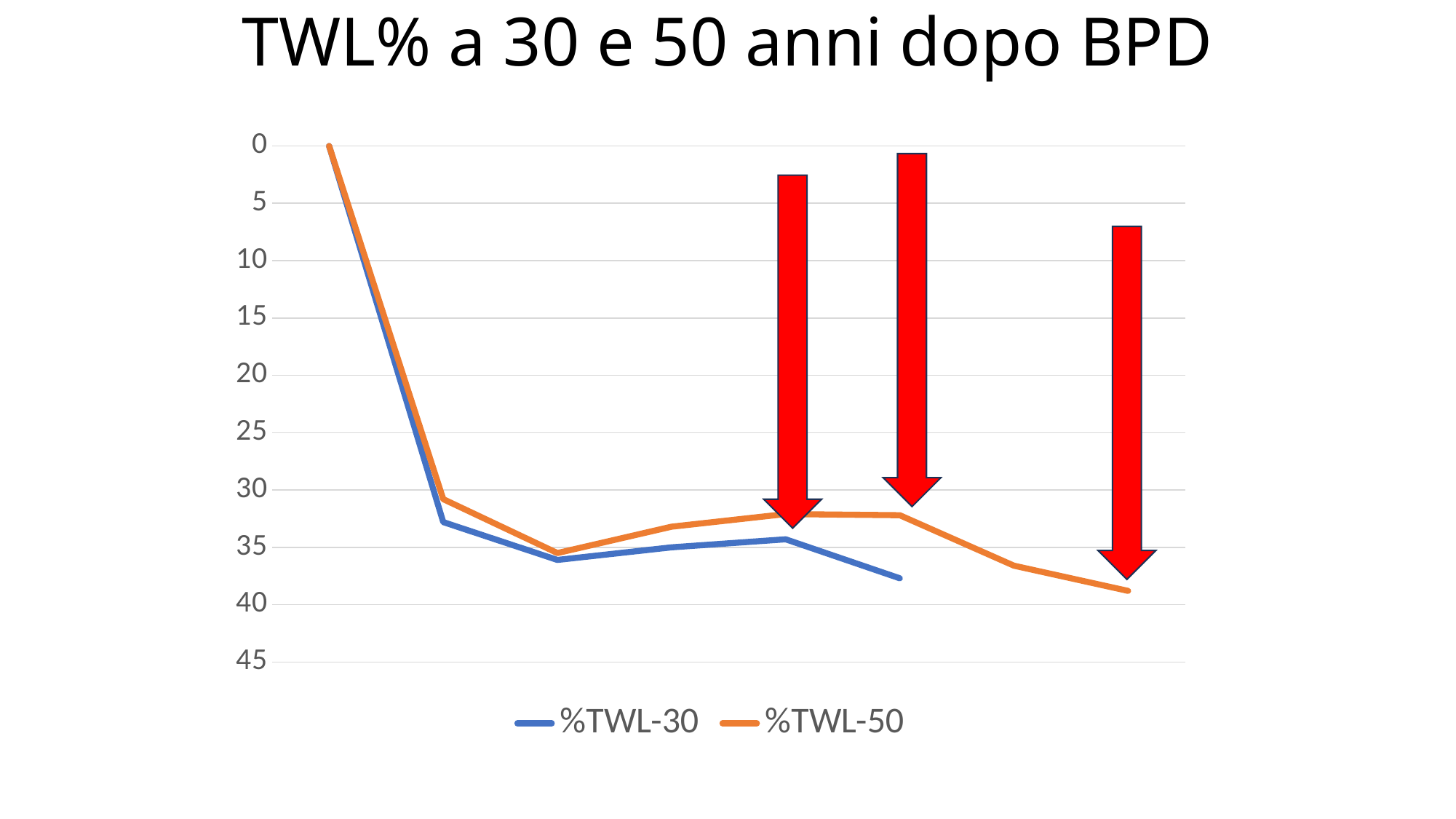
How many points are plotted for the %TWL-50 series? 8 What is the value of the first point of the %TWL-30 series? 0 What is the title of the chart? TWL% a 30 e 50 anni dopo BPD How many points are plotted for the %TWL-30 series? 6 Is the value of the last point of the %TWL-30 series greater or less than 35? greater What kind of chart is shown on the slide? line chart Is the value of the last point of the %TWL-50 series greater or less than 35? greater What is the value of the first point of the %TWL-50 series? 0 Which series has more plotted points, %TWL-30 or %TWL-50? %TWL-50 Is the value of the last point of the %TWL-50 series greater or less than 40? less How many series does the legend list? 2 What are the two series named in the legend? %TWL-30 and %TWL-50